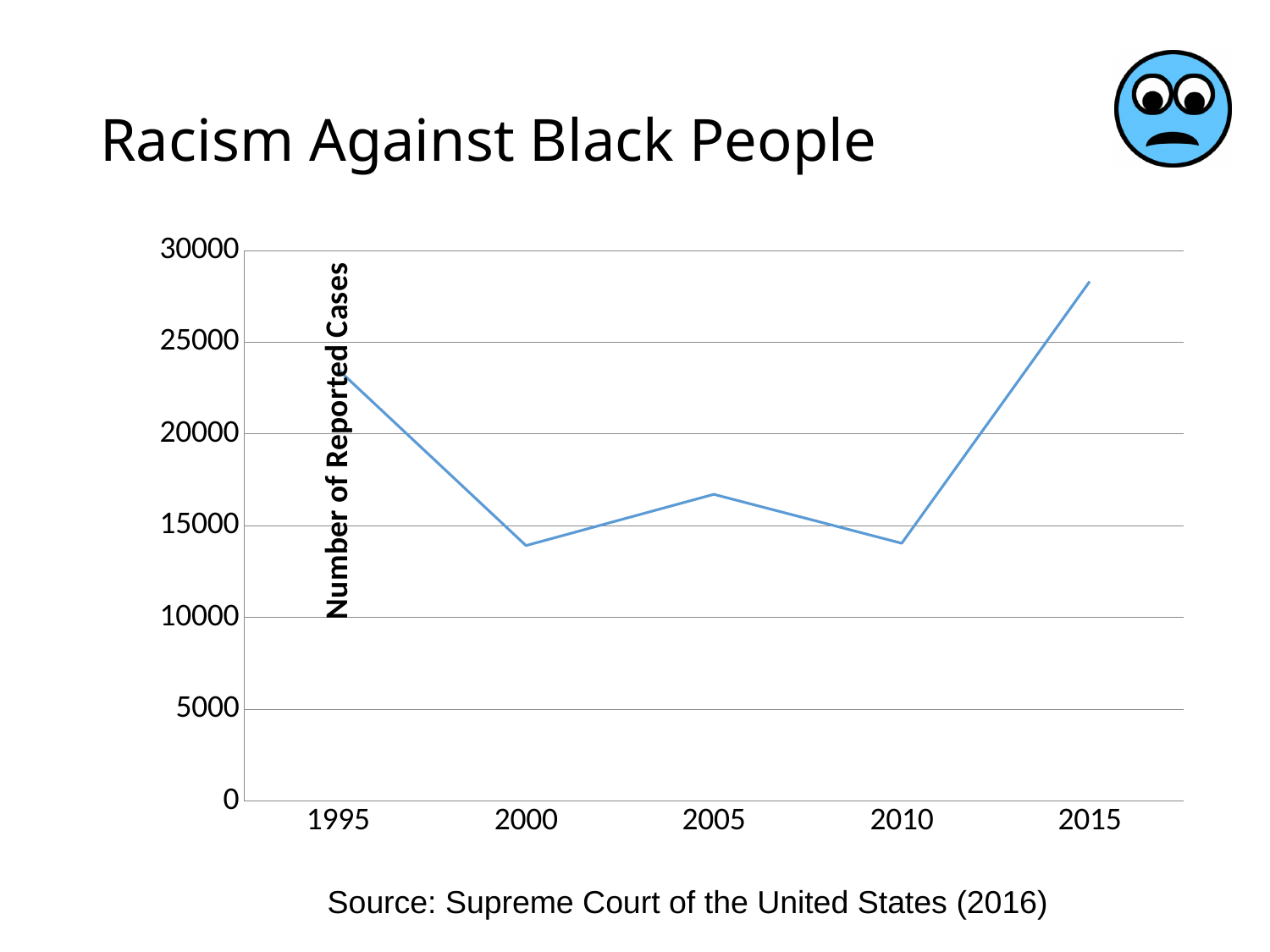
Is the value for 1995 greater or less than 20000? greater Is the value for 2000 greater or less than 15000? less Which is larger, the value for 2005 or the value for 2010? 2005 How many years are plotted on the x axis? 5 Do the values rise or fall from 1995 to 2000? fall Do the values rise or fall from 2010 to 2015? rise Is the value for 2005 greater or less than 15000? greater Which year has the highest number of reported cases? 2015 Which is larger, the value for 1995 or the value for 2005? 1995 What kind of chart is shown on the slide? line chart What is the label on the vertical axis of the chart? Number of Reported Cases